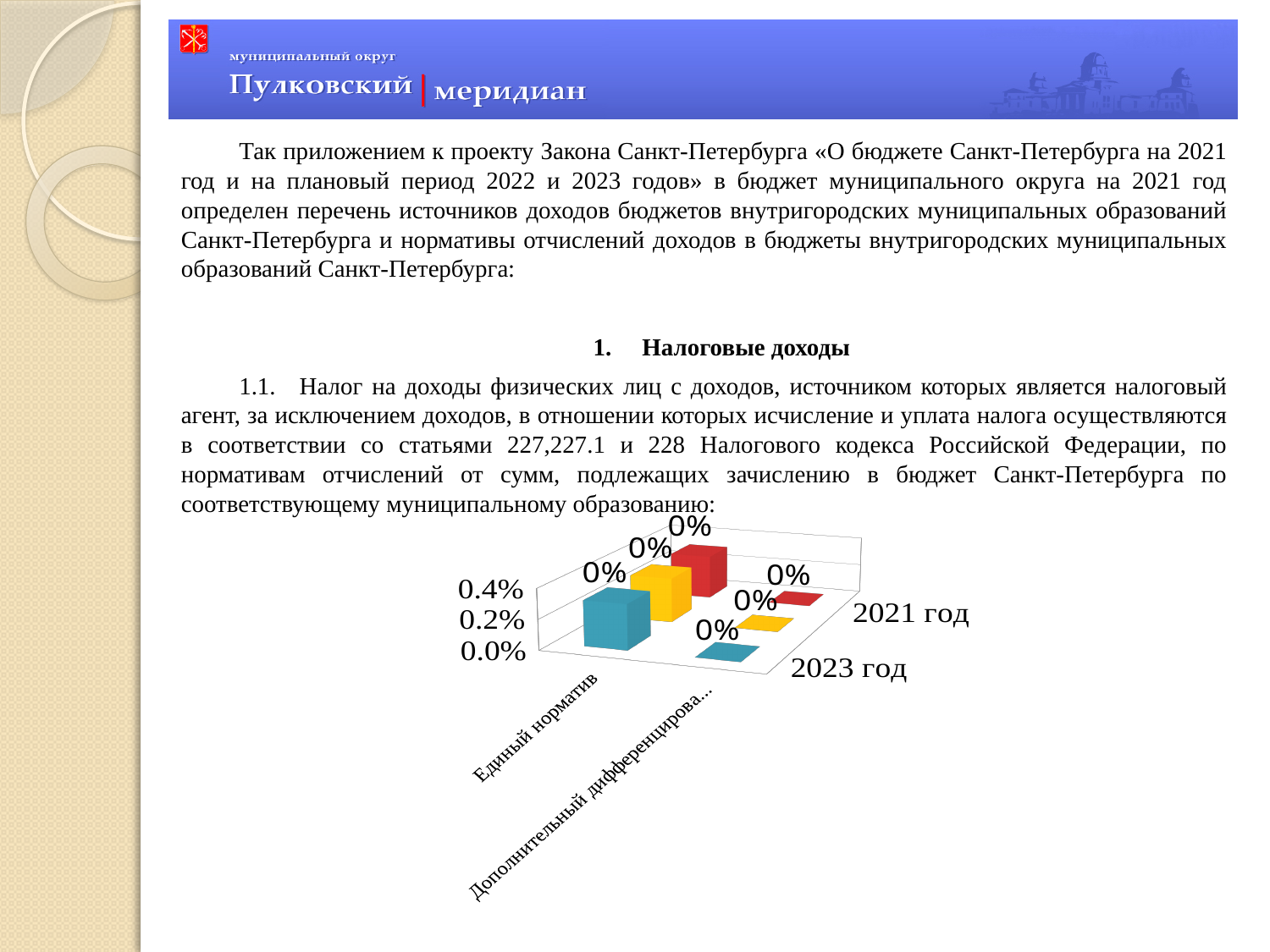
What data label is printed on the bar for "Единый норматив" in the 2021 год series? 0% How many categories are shown on the category axis of the chart? 2 What is the highest tick value shown on the vertical axis of the chart? 0.4% Which category has the larger bar in the 2023 год series, "Единый норматив" or "Дополнительный дифференцирова..."? Единый норматив What colour are the bars in the front row (2023 год) of the chart? blue What data label is printed on the bar for "Единый норматив" in the 2023 год series? 0% Which category has the lowest bars in the chart? Дополнительный дифференцирова... Which category has the tallest bars in the chart? Единый норматив Is the value for "Дополнительный дифференцирова..." in the 2023 год series greater or less than 0.2%? less What kind of chart is shown on the slide? bar chart